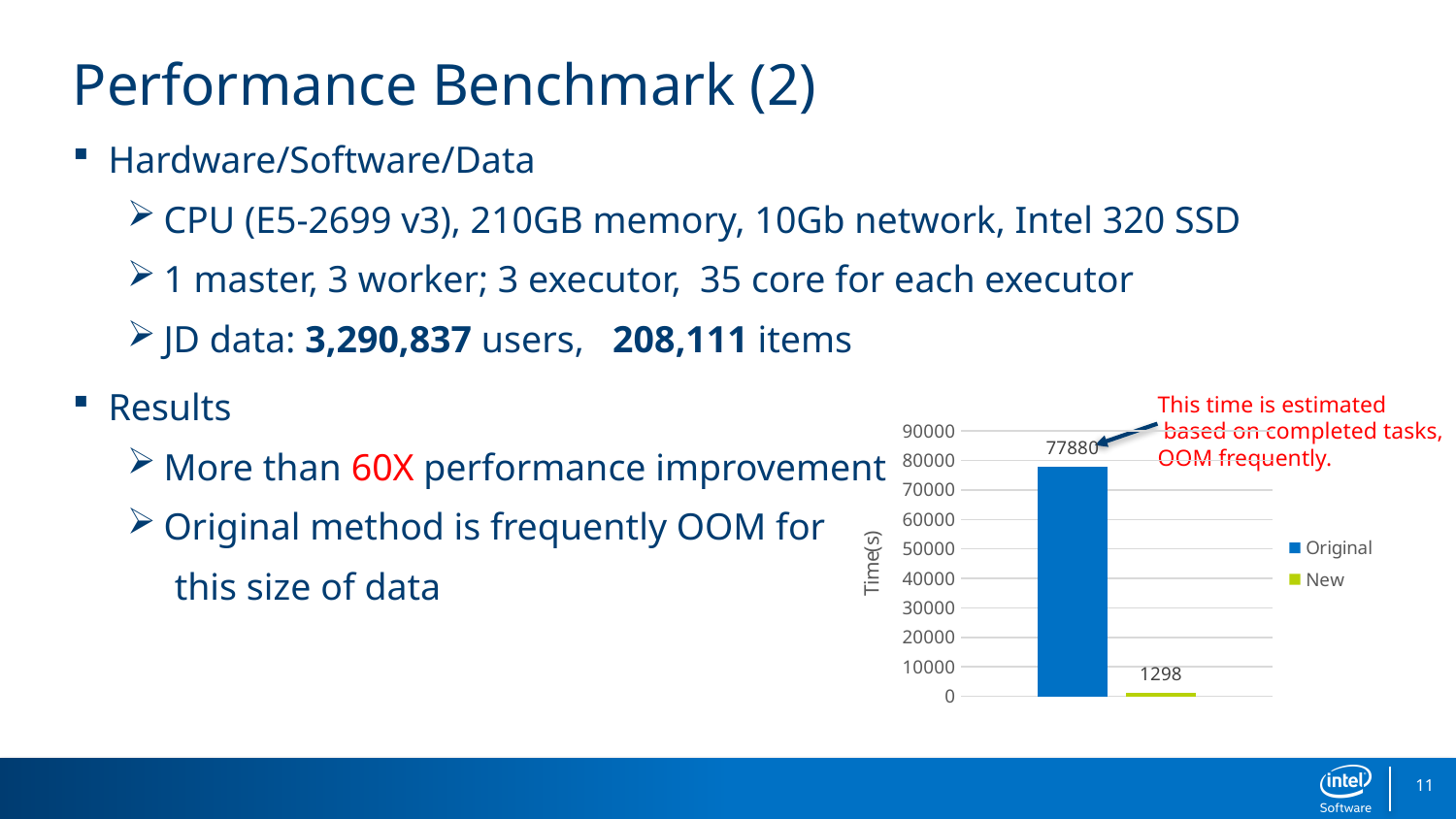
What is the difference between the Original and New values in the chart? 76582 Which series has the lowest value in the chart? New What is the value of the Original bar in the chart? 77880 Which series has the higher value in the chart, Original or New? Original What kind of chart is shown on the slide? bar chart What colour is the Original series in the chart? blue What is the label of the y axis of the chart? Time(s) What is the value of the New bar in the chart? 1298 Is the value for Original greater or less than 70000? greater Is the value for New greater or less than 10000? less What is the highest tick value shown on the y axis of the chart? 90000 How many series does the chart legend list? 2